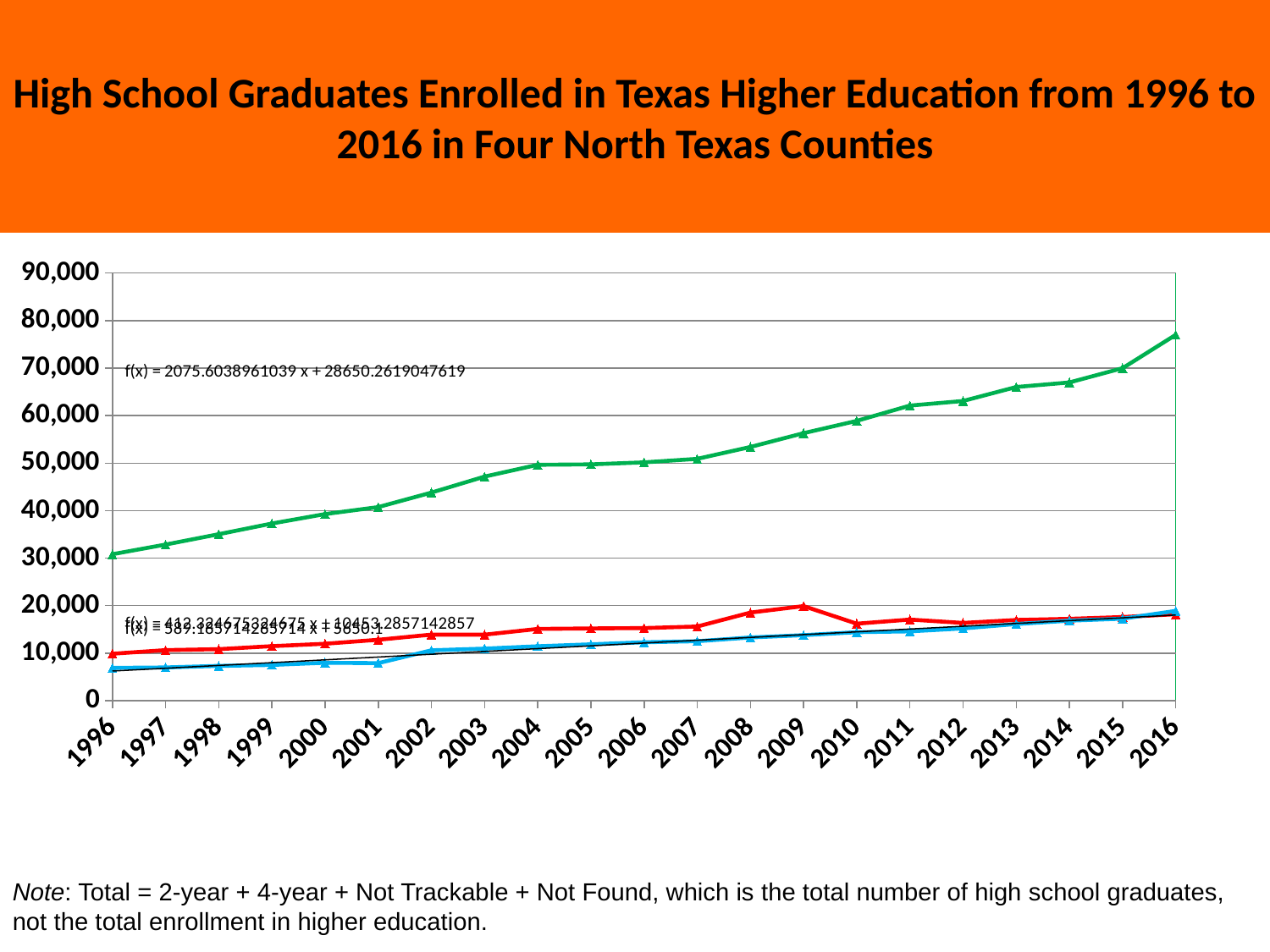
Is the value of the green line in 2016 greater or less than 70,000? greater In which year does the green line reach its highest value? 2016 Is the value of the green line in 2013 greater or less than 60,000? greater What kind of chart is shown on the slide? line chart Is the value of the blue line in 1996 greater or less than 10,000? less In which year does the green line have its lowest value? 1996 What is the title of the chart on the slide? High School Graduates Enrolled in Texas Higher Education from 1996 to 2016 in Four North Texas Counties Does the green line rise or fall from 1996 to 2016? rise What is the first year shown on the x axis? 1996 How many years are shown along the x axis of the chart? 21 In 2016, which line has the larger value, the green line or the red line? green line